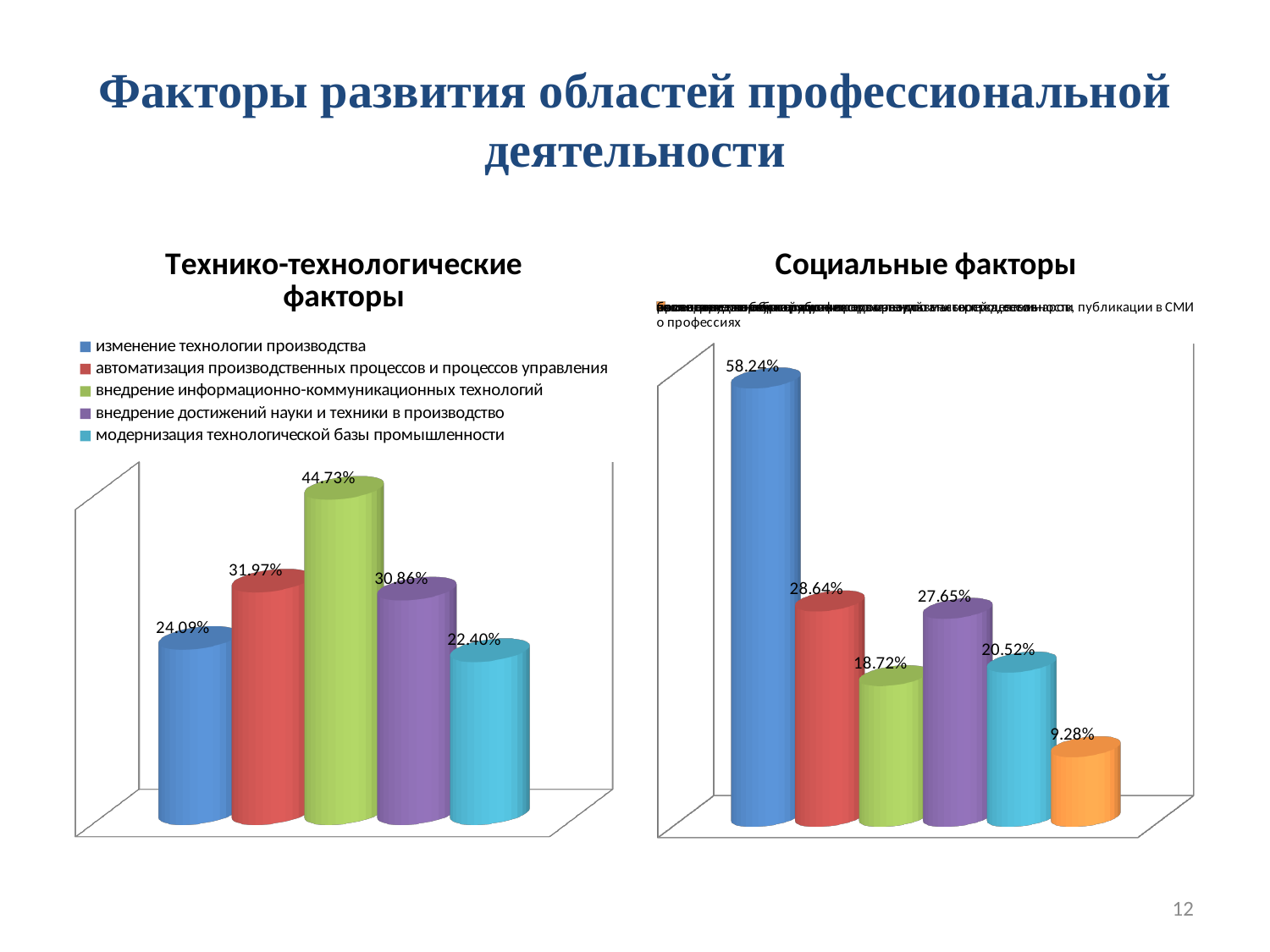
In the chart titled "Технико-технологические факторы", what is the value for "изменение технологии производства"? 24.09% How many series does the legend of the chart titled "Технико-технологические факторы" list? 5 In the chart titled "Социальные факторы", what is the value of the tallest (first, blue) bar? 58.24% In the chart titled "Социальные факторы", what is the difference between the first (blue) bar and the second (red) bar? 29.60% In the chart titled "Технико-технологические факторы", what is the difference between the values for "автоматизация производственных процессов и процессов управления" and "внедрение достижений науки и техники в производство"? 1.11% In the chart titled "Технико-технологические факторы", which is larger: the value for "автоматизация производственных процессов и процессов управления" or for "модернизация технологической базы промышленности"? автоматизация производственных процессов и процессов управления In the chart titled "Технико-технологические факторы", which category has the lowest value? модернизация технологической базы промышленности In the chart titled "Социальные факторы", what is the value of the lowest (last, orange) bar? 9.28% In the chart titled "Технико-технологические факторы", which category has the highest value? внедрение информационно-коммуникационных технологий What kind of chart is the chart titled "Социальные факторы"? bar chart How many bars are plotted in the chart titled "Социальные факторы"? 6 In the chart titled "Технико-технологические факторы", what is the value for "внедрение информационно-коммуникационных технологий"? 44.73%